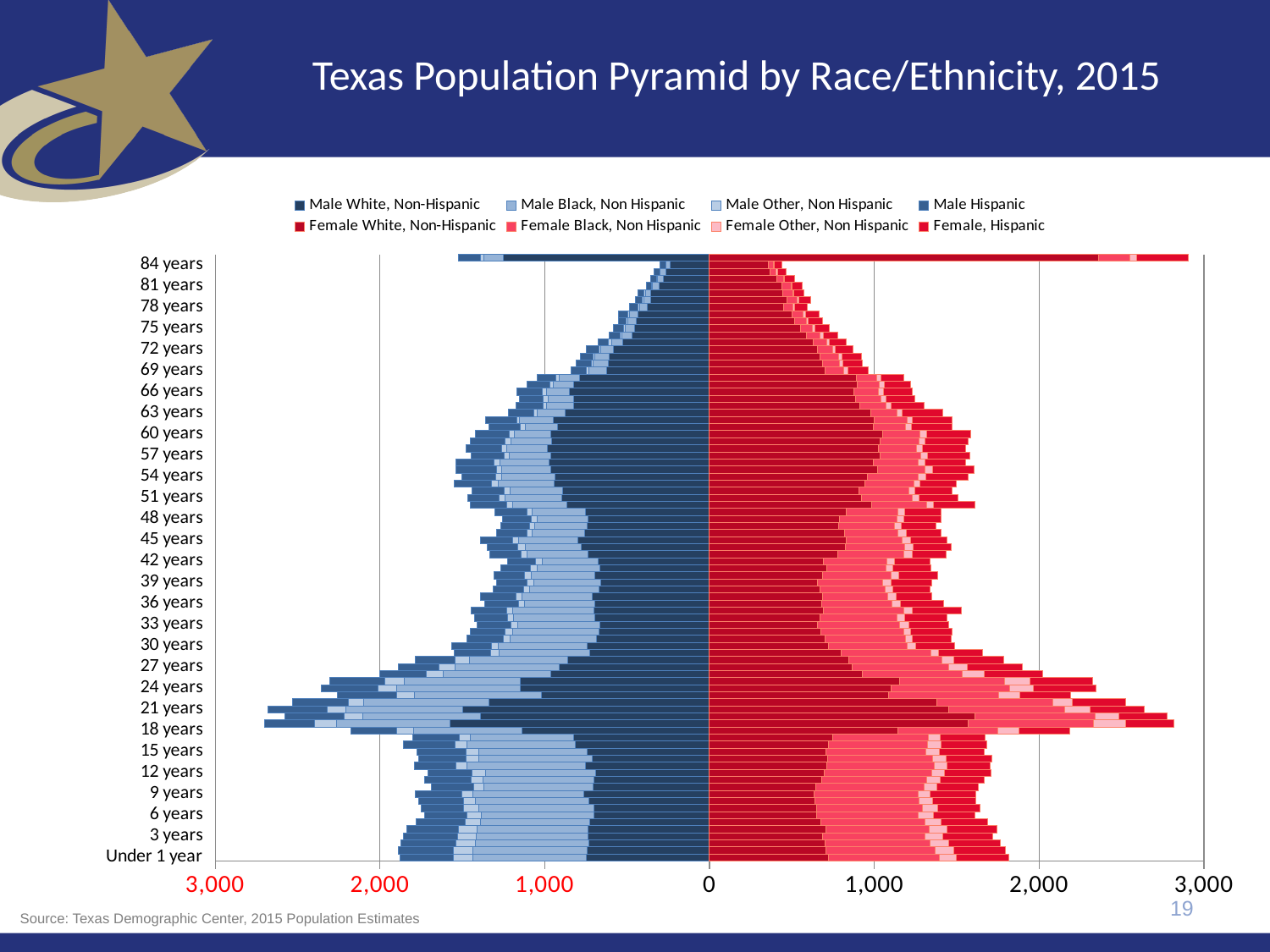
How many series does the legend list? 8 Is the total female bar for 18 years greater or less than 2,000? greater Which is larger, the total male bar for 18 years or the total male bar for 69 years? 18 years Is the total male bar for 69 years greater or less than 1,000? less Is the total female bar for 78 years greater or less than 1,000? less What is the title of the chart? Texas Population Pyramid by Race/Ethnicity, 2015 Which colour family is used for the male series and which for the female series? Male series are blue; female series are red Which is larger, the total female bar for 21 years or the total female bar for 75 years? 21 years What kind of chart is shown on the slide? Bar chart (population pyramid)